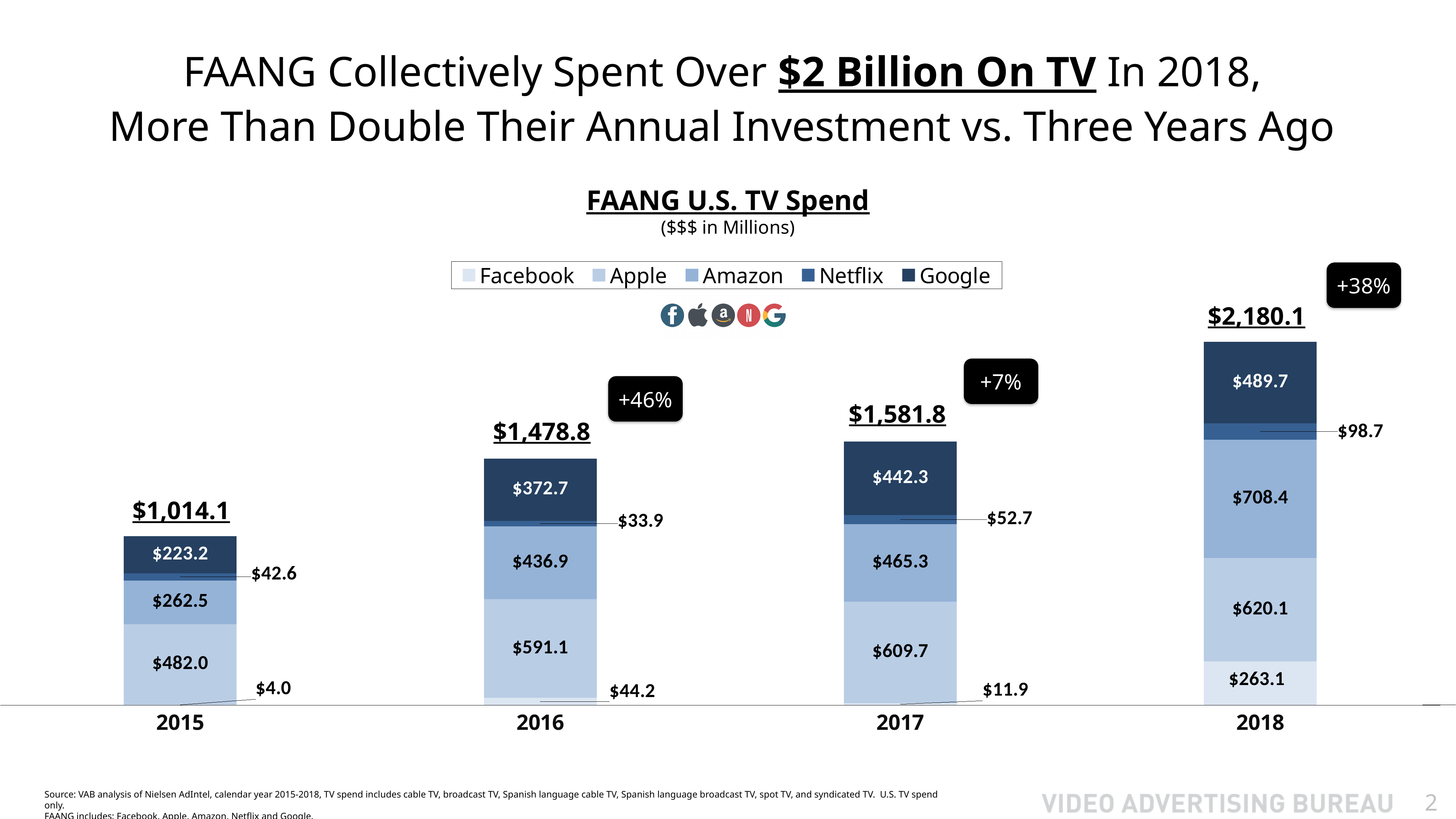
What was Netflix's U.S. TV spend in 2016? $33.9 Which year has the lowest total FAANG U.S. TV spend? 2015 What was Facebook's U.S. TV spend in 2015? $4.0 Which year has the highest total FAANG U.S. TV spend? 2018 How much more did Apple spend on U.S. TV in 2018 than in 2015? $138.1 What was Amazon's U.S. TV spend in 2017? $465.3 What kind of chart is used to show FAANG U.S. TV Spend? Stacked bar chart How many companies does the legend list? 5 What is the total FAANG U.S. TV spend shown for 2018? $2,180.1 What was Google's U.S. TV spend in 2018? $489.7 What is the total FAANG U.S. TV spend shown for 2015? $1,014.1 In 2018, which spent more on U.S. TV: Amazon or Apple? Amazon